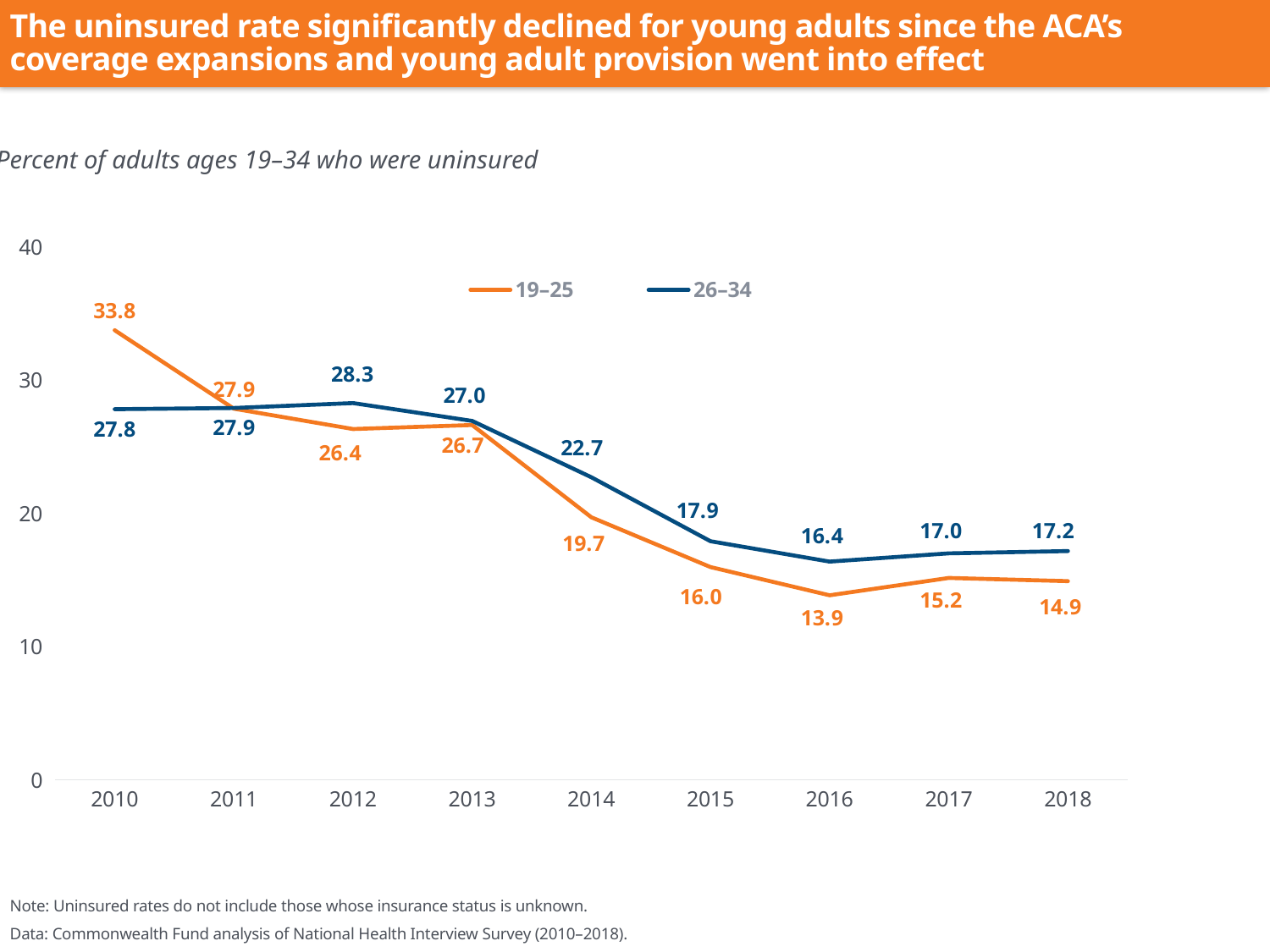
How many years are shown on the x axis? 9 In which year was the uninsured rate for ages 19–25 lowest? 2016 In which year was the uninsured rate for ages 26–34 highest? 2012 Which group had the higher uninsured rate in 2014, ages 19–25 or ages 26–34? 26–34 What kind of chart is shown on the slide? line chart What was the uninsured rate for adults ages 26–34 in 2018? 17.2 What was the uninsured rate for adults ages 19–25 in 2010? 33.8 What is the difference between the 19–25 uninsured rate in 2010 and in 2018? 18.9 What was the uninsured rate for adults ages 19–25 in 2016? 13.9 How many series does the legend list? 2 Does the uninsured rate for ages 19–25 generally rise or fall from 2010 to 2018? fall Is the uninsured rate for ages 19–25 in 2013 greater or less than 30? less